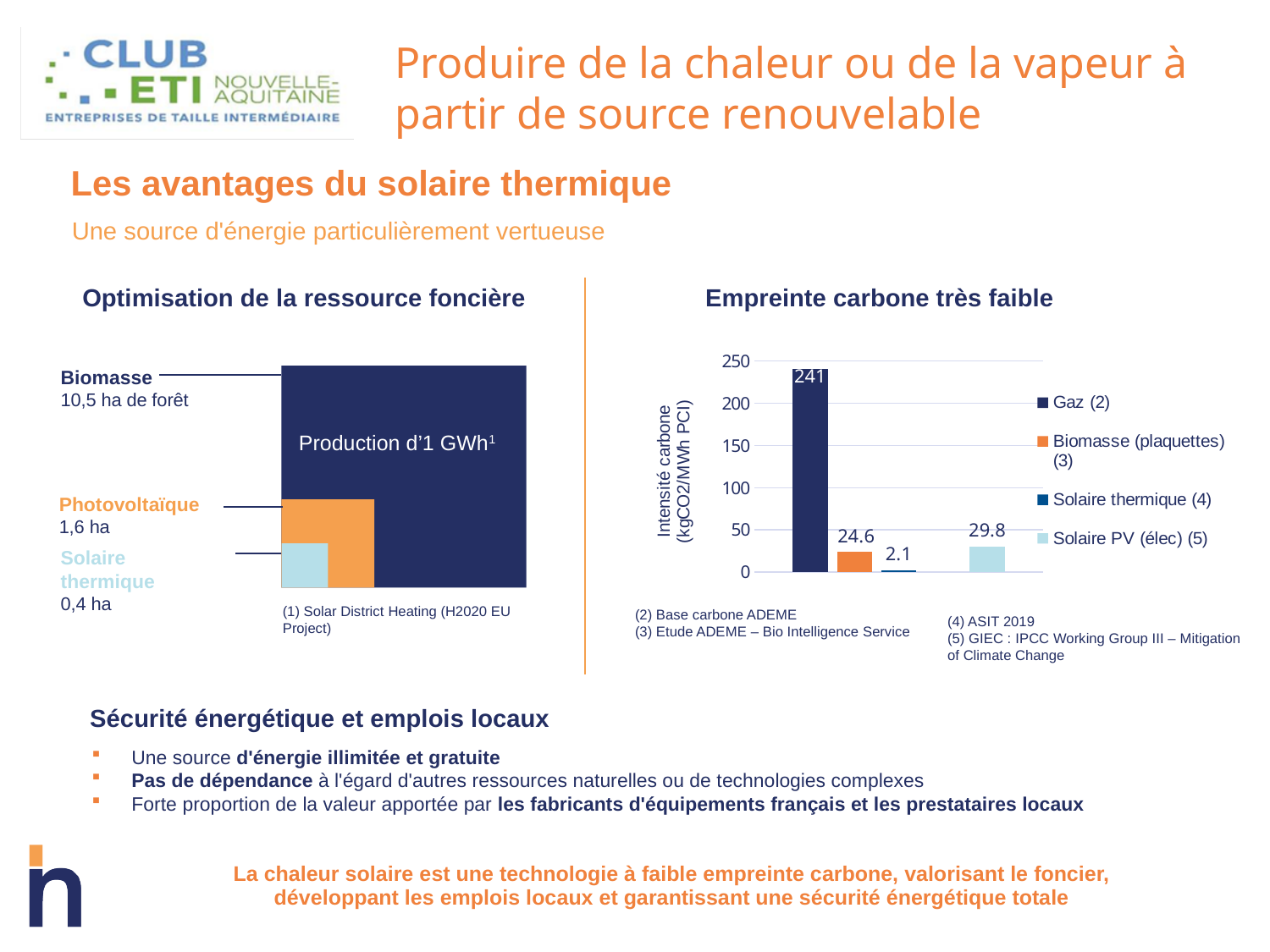
In the 'Empreinte carbone très faible' chart, what is the difference between the values for Gaz (2) and Solaire thermique (4)? 238.9 What kind of chart is the 'Empreinte carbone très faible' chart? bar chart How many series does the legend of the 'Empreinte carbone très faible' chart list? 4 In the 'Empreinte carbone très faible' chart, which series has the lowest value? Solaire thermique (4) In the 'Empreinte carbone très faible' chart, what is the value for Solaire PV (élec) (5)? 29.8 In the 'Empreinte carbone très faible' chart, what is the value for Gaz (2)? 241 In the 'Empreinte carbone très faible' chart, what is the value for Biomasse (plaquettes) (3)? 24.6 In the 'Empreinte carbone très faible' chart, which is larger: Biomasse (plaquettes) (3) or Solaire PV (élec) (5)? Solaire PV (élec) (5) What is the y-axis label of the 'Empreinte carbone très faible' chart? Intensité carbone (kgCO2/MWh PCI) In the 'Empreinte carbone très faible' chart, is the value for Gaz (2) greater or less than 200? greater In the 'Empreinte carbone très faible' chart, which series has the highest value? Gaz (2) In the 'Empreinte carbone très faible' chart, what is the value for Solaire thermique (4)? 2.1